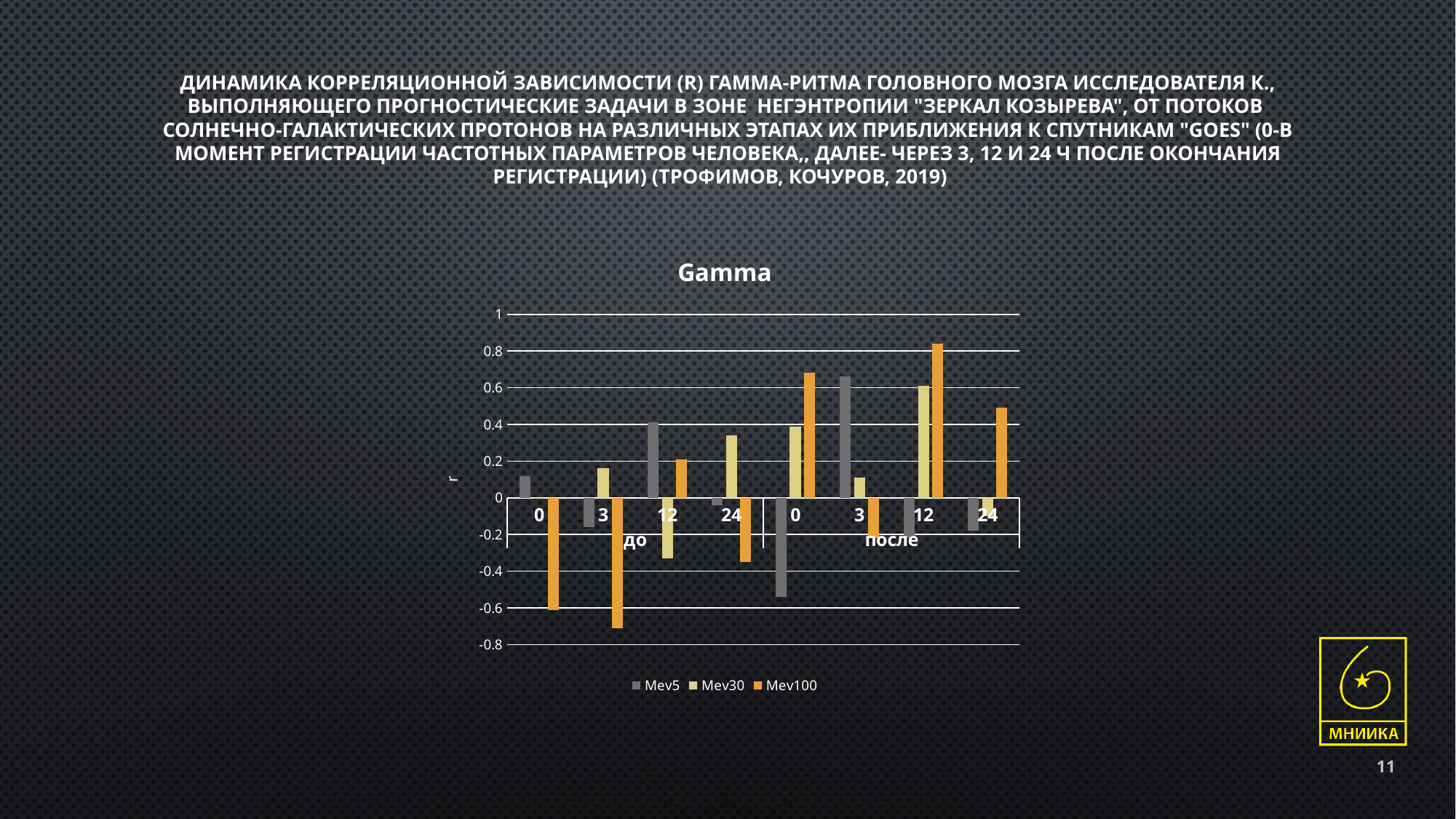
At which time point does the Mev5 series reach its highest value? 3 (после) What is the label on the vertical axis of the "Gamma" chart? r What are the series names in the legend of the "Gamma" chart? Mev5, Mev30, Mev100 At which time point does the Mev100 series reach its highest value? 12 (после) How many time points (bar groups) are plotted on the x axis of the "Gamma" chart across both the "до" and "после" sections? 8 Is the Mev100 value at time point 0 in the "до" section greater or less than -0.4? less What kind of chart is the "Gamma" chart? bar chart At which time point does the Mev30 series reach its lowest value? 12 (до) In the "после" section at time point 12, which series has the larger value, Mev30 or Mev100? Mev100 How many series does the legend of the "Gamma" chart list? 3 At which time point does the Mev5 series reach its lowest value? 0 (после) At which time point does the Mev100 series reach its lowest value? 3 (до)